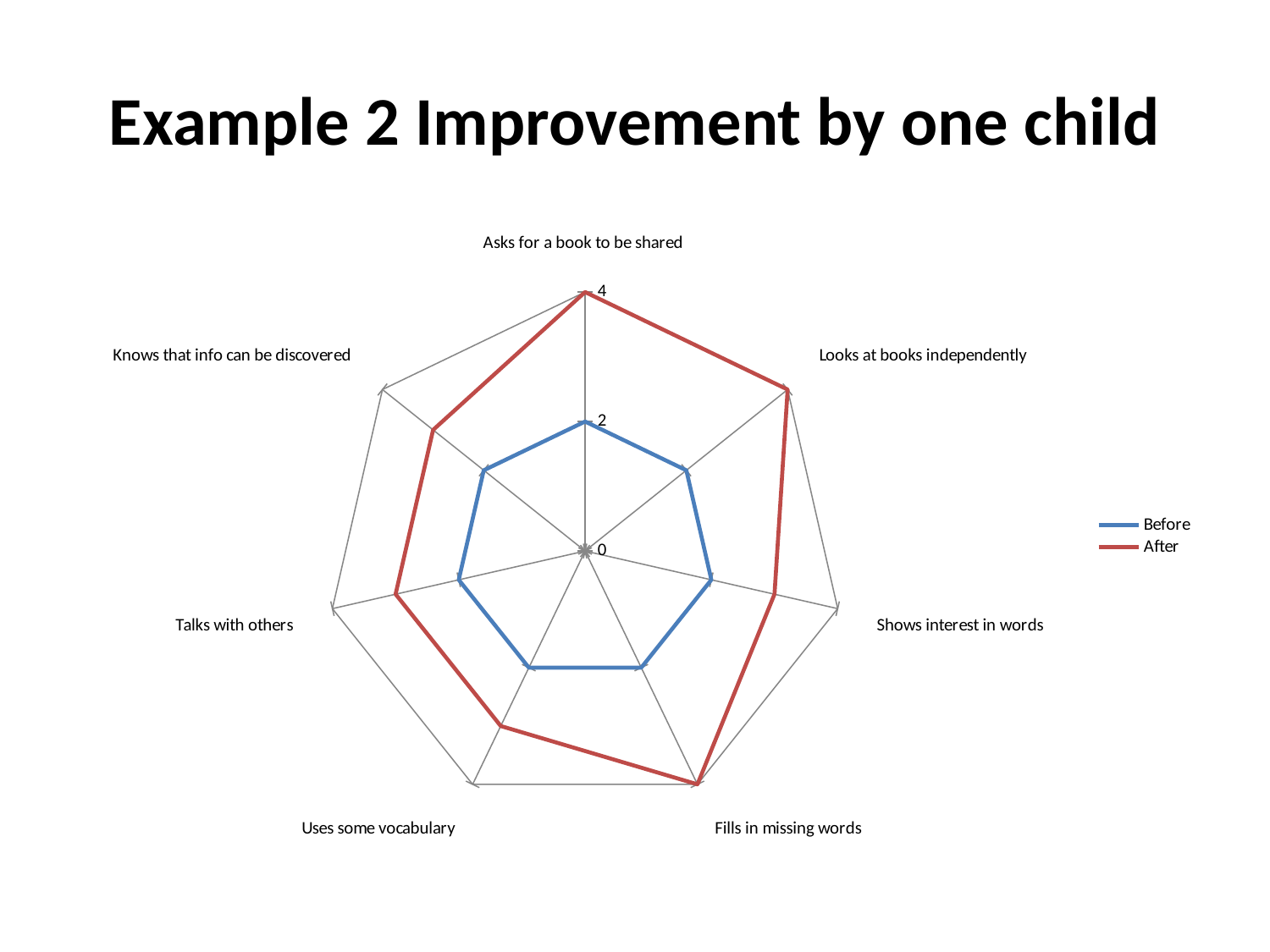
Is the Before value for 'Fills in missing words' greater or less than 4? less What is the Before value for 'Asks for a book to be shared'? 2 What is the After value for 'Asks for a book to be shared'? 4 What kind of chart is shown on the slide? Radar chart What is the difference between the After and Before values for 'Asks for a book to be shared'? 2 Is the After value for 'Knows that info can be discovered' greater or less than 2? greater Is the After value for 'Uses some vocabulary' greater or less than 4? less Which series has the larger value for 'Looks at books independently', Before or After? After How many series does the legend list? 2 What colour is the After series line? Red What are the two series named in the legend? Before and After How many categories (axes) does the radar chart have? 7